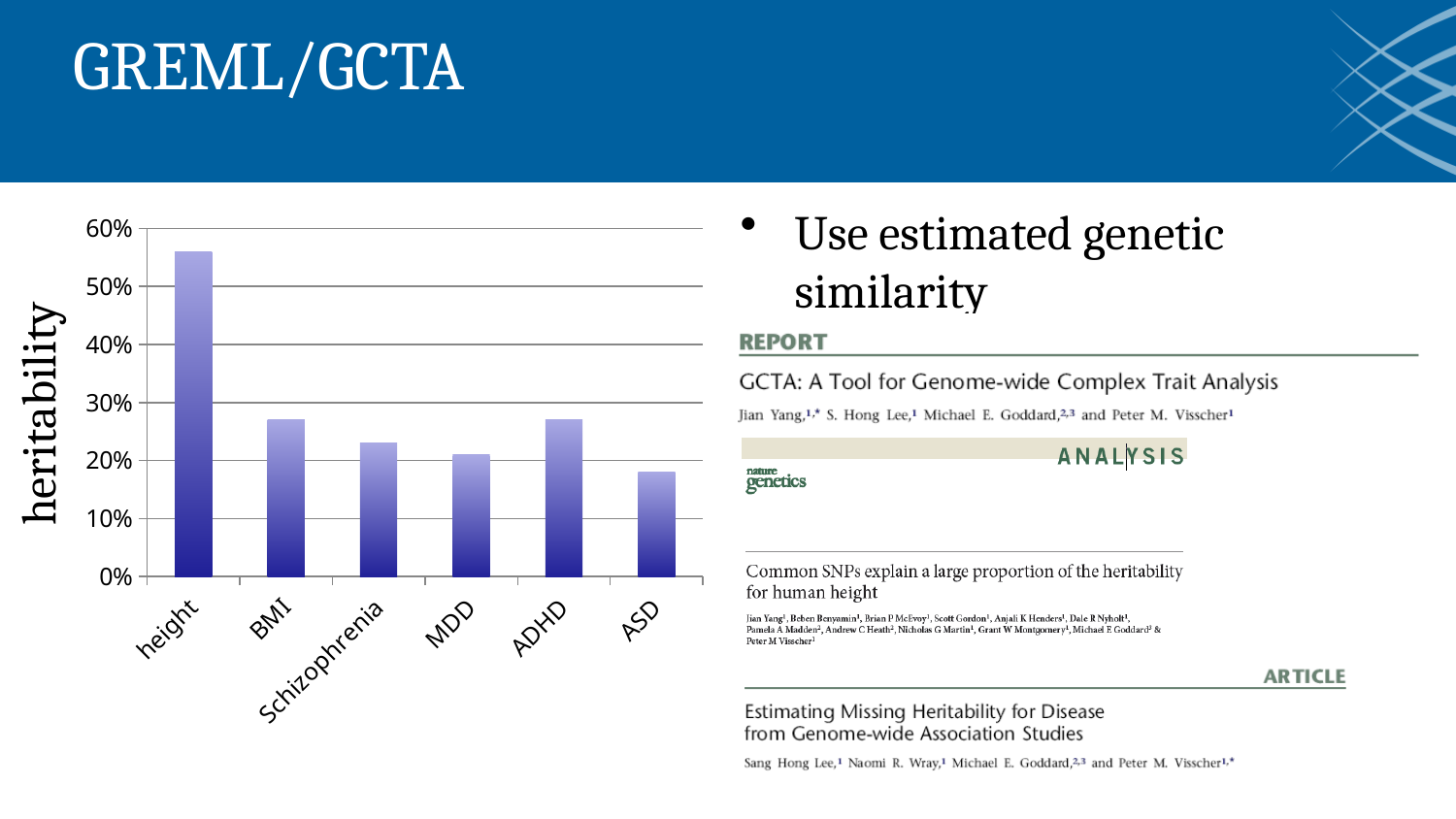
Is the heritability value for ASD greater or less than 20%? less Which category has the lowest heritability in the chart? ASD Which has the larger heritability, ADHD or ASD? ADHD What is the label on the y axis of the chart? heritability Is the heritability value for height greater or less than 50%? greater Is the heritability value for BMI greater or less than 20%? greater What kind of chart is shown on the slide? bar chart Which has the larger heritability, height or BMI? height How many categories are shown on the x axis of the chart? 6 Which category has the highest heritability in the chart? height